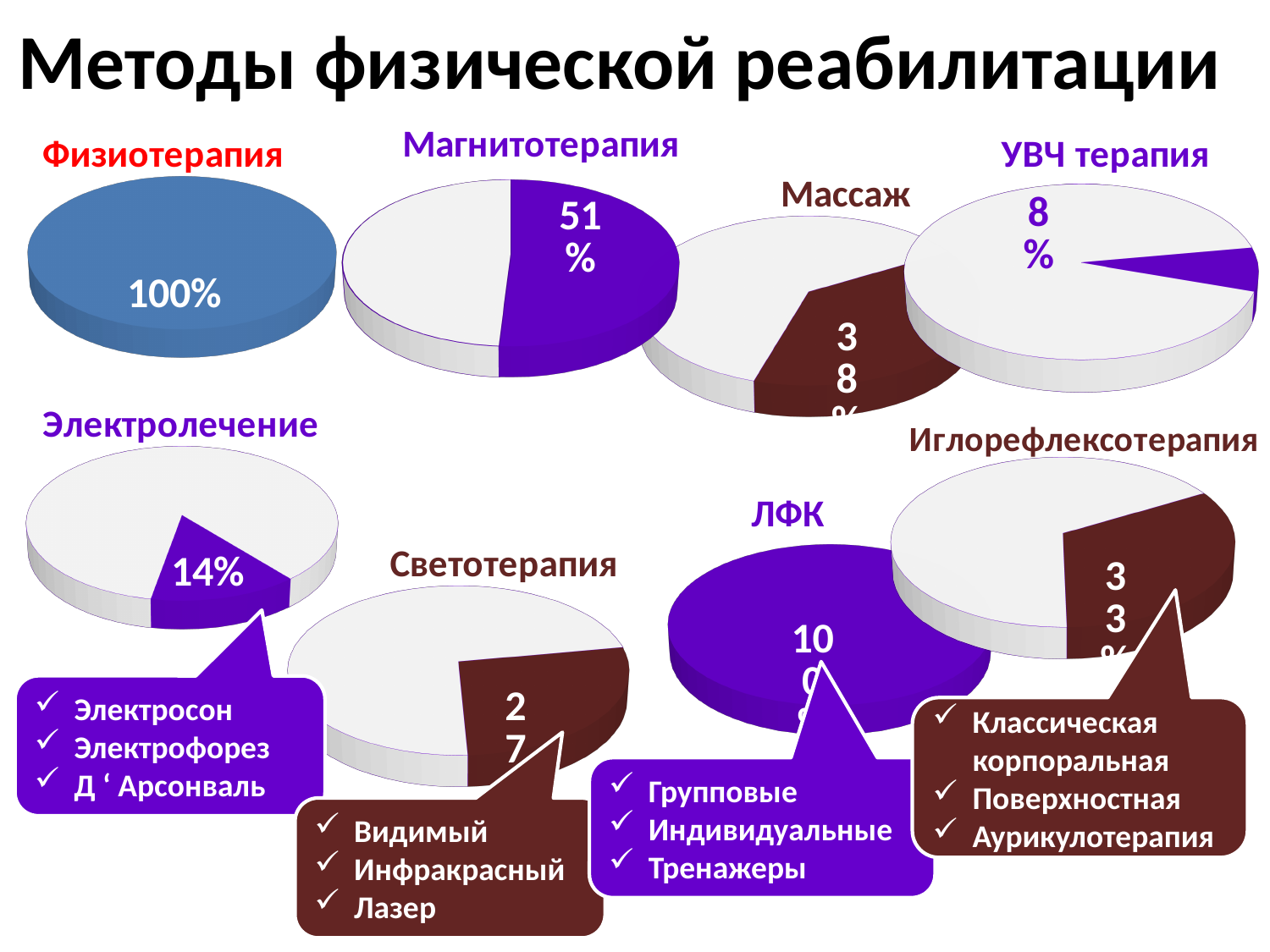
What is the difference between the Магнитотерапия slice (51%) and the УВЧ терапия slice (8%)? 43% In the Магнитотерапия chart, what share does the highlighted slice have? 51% In the УВЧ терапия chart, what percentage is labelled on the slice? 8% In the Электролечение chart, what share does the highlighted slice have? 14% In the Физиотерапия chart, what percentage is shown? 100% Which highlighted slice is larger: the one in the Магнитотерапия chart or the one in the УВЧ терапия chart? Магнитотерапия Which highlighted slice is larger: the one in the Электролечение chart or the one in the УВЧ терапия chart? Электролечение Is the highlighted slice in the Магнитотерапия chart greater or less than 50%? greater Which chart title is written in red? Физиотерапия What kind of chart is used for Физиотерапия? pie chart How many pie charts are shown on the slide? 8 What is the title of the slide? Методы физической реабилитации